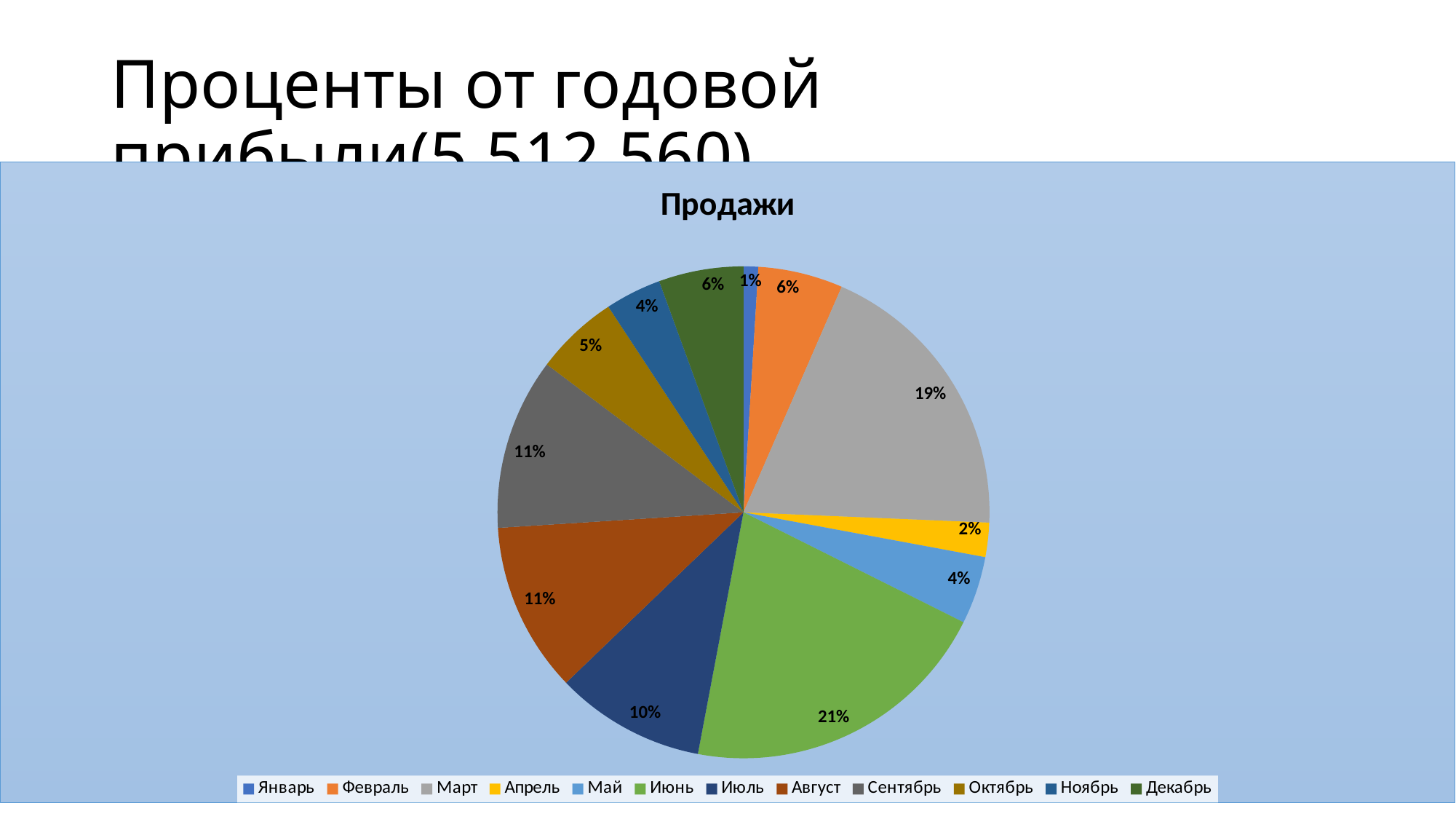
What is the chart's title? Продажи What share of the pie does Март have? 19% What is the value for Ноябрь? 4% Which month has the largest slice? Июнь What is the difference between the values for Июнь and Март? 2% Which month has the smallest slice? Январь Which is larger, the value for Февраль or the value for Октябрь? Февраль What is the value for Июль? 10% What kind of chart is shown on the slide? pie chart How many slices does the pie chart have? 12 What share of the pie does Июнь have? 21% What is the value for Апрель? 2%